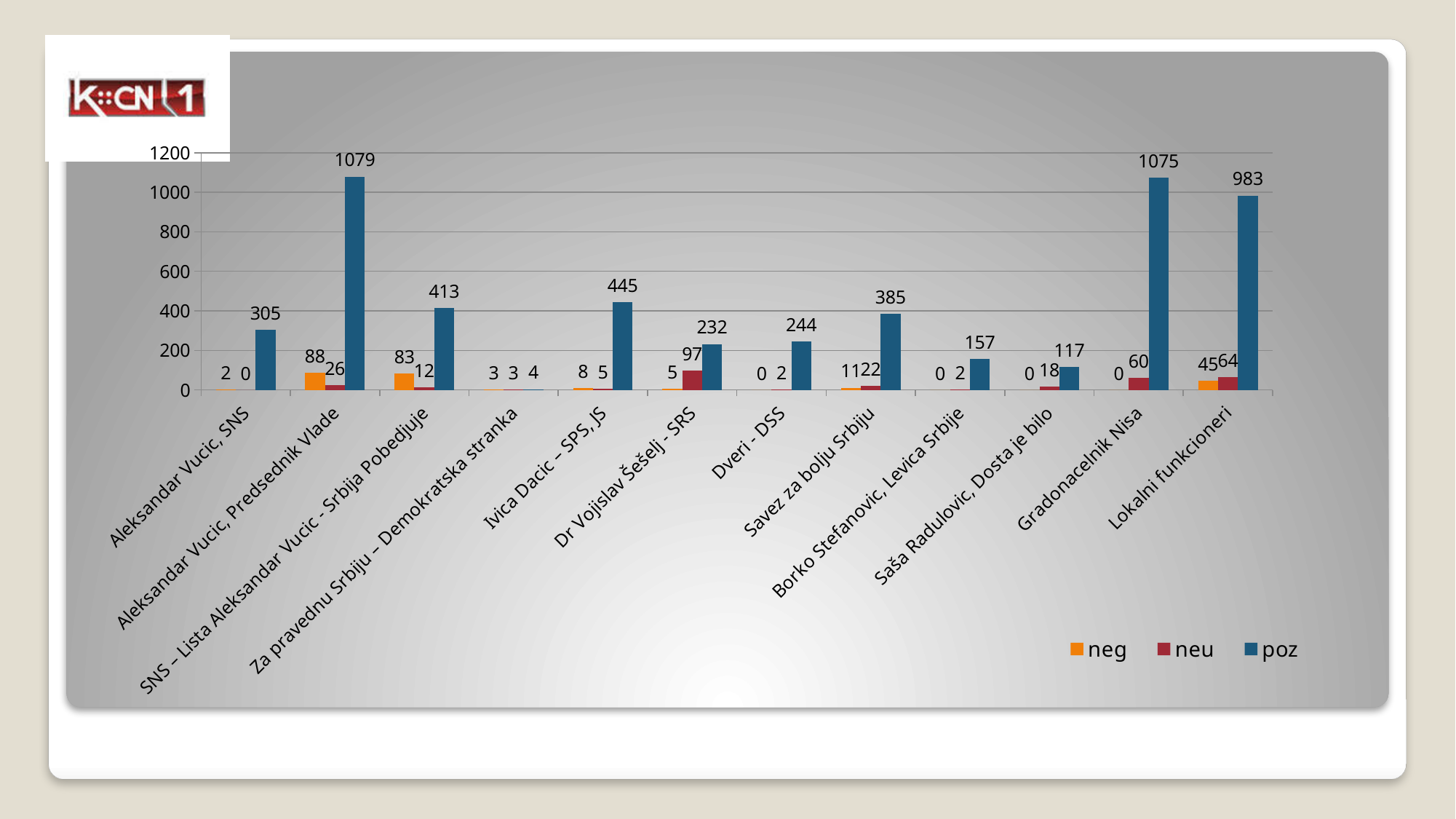
What kind of chart is shown on the slide? Bar chart Which has a larger poz value: Ivica Dacic – SPS,JS or SNS – Lista Aleksandar Vucic - Srbija Pobedjuje? Ivica Dacic – SPS,JS What is the poz value for Lokalni funkcioneri? 983 What is the neu value for Dr Vojislav Šešelj - SRS? 97 Which category has the lowest poz value? Za pravednu Srbiju – Demokratska stranka Which category has the highest poz value? Aleksandar Vucic, Predsednik Vlade What is the poz value for Aleksandar Vucic, Predsednik Vlade? 1079 How many categories are shown on the x axis? 12 What is the difference between the poz values for Dveri - DSS and Borko Stefanovic, Levica Srbije? 87 What is the neu value for Gradonacelnik Nisa? 60 How many series does the legend list? 3 What is the difference between the poz values for Aleksandar Vucic, Predsednik Vlade and Gradonacelnik Nisa? 4